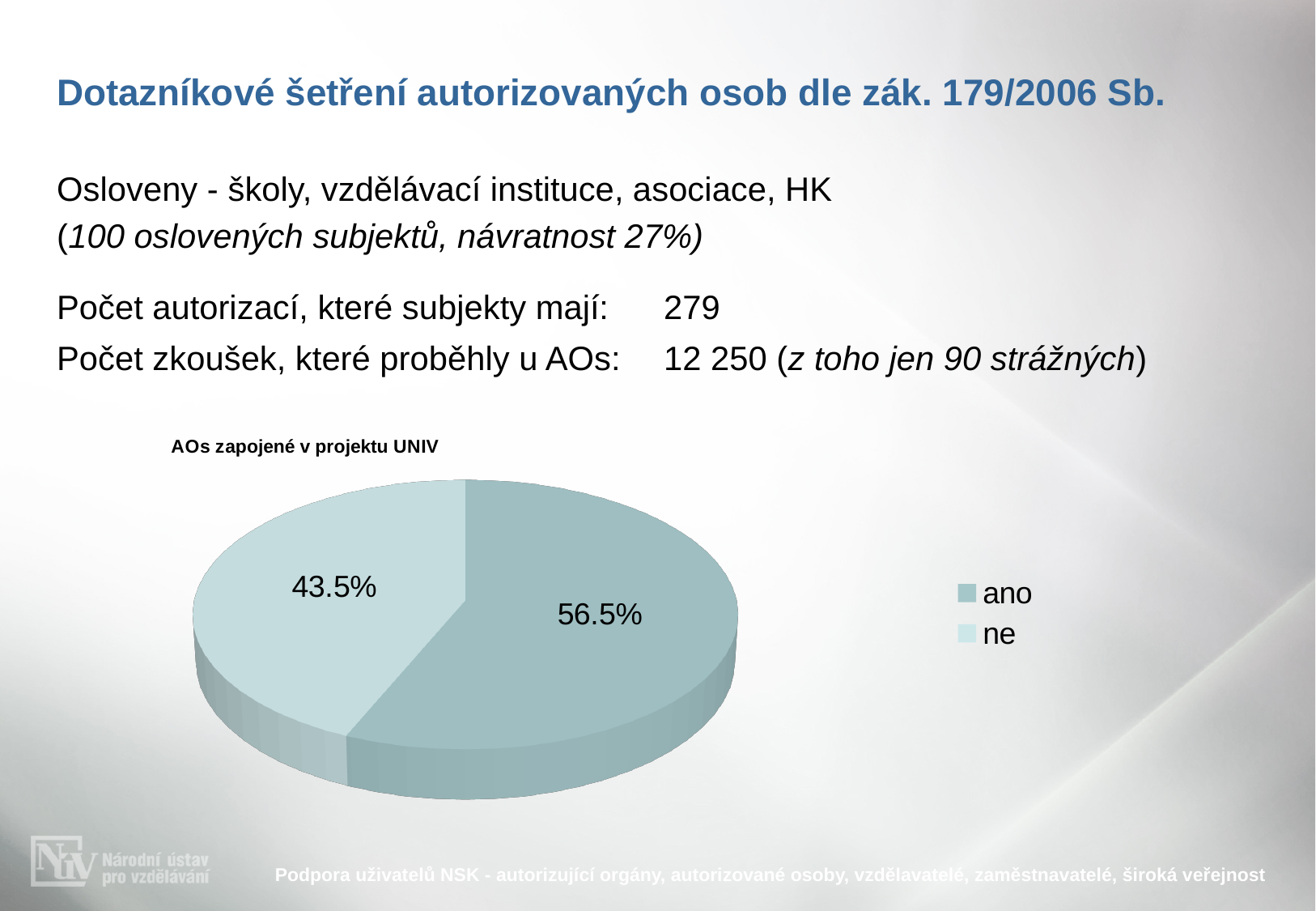
What kind of chart is shown on the slide? pie chart What share of the pie does the "ano" slice represent? 56.5% How many slices does the pie chart have? 2 What share of the pie does the "ne" slice represent? 43.5% Which is larger, the "ano" slice or the "ne" slice? ano How many entries does the legend list? 2 Which slice of the pie chart is the largest? ano Is the share for "ano" greater or less than 50%? greater What is the title of the pie chart? AOs zapojené v projektu UNIV What is the difference between the "ano" and "ne" shares? 13% Which legend entry is shown in the lighter colour? ne Which slice of the pie chart is the smallest? ne